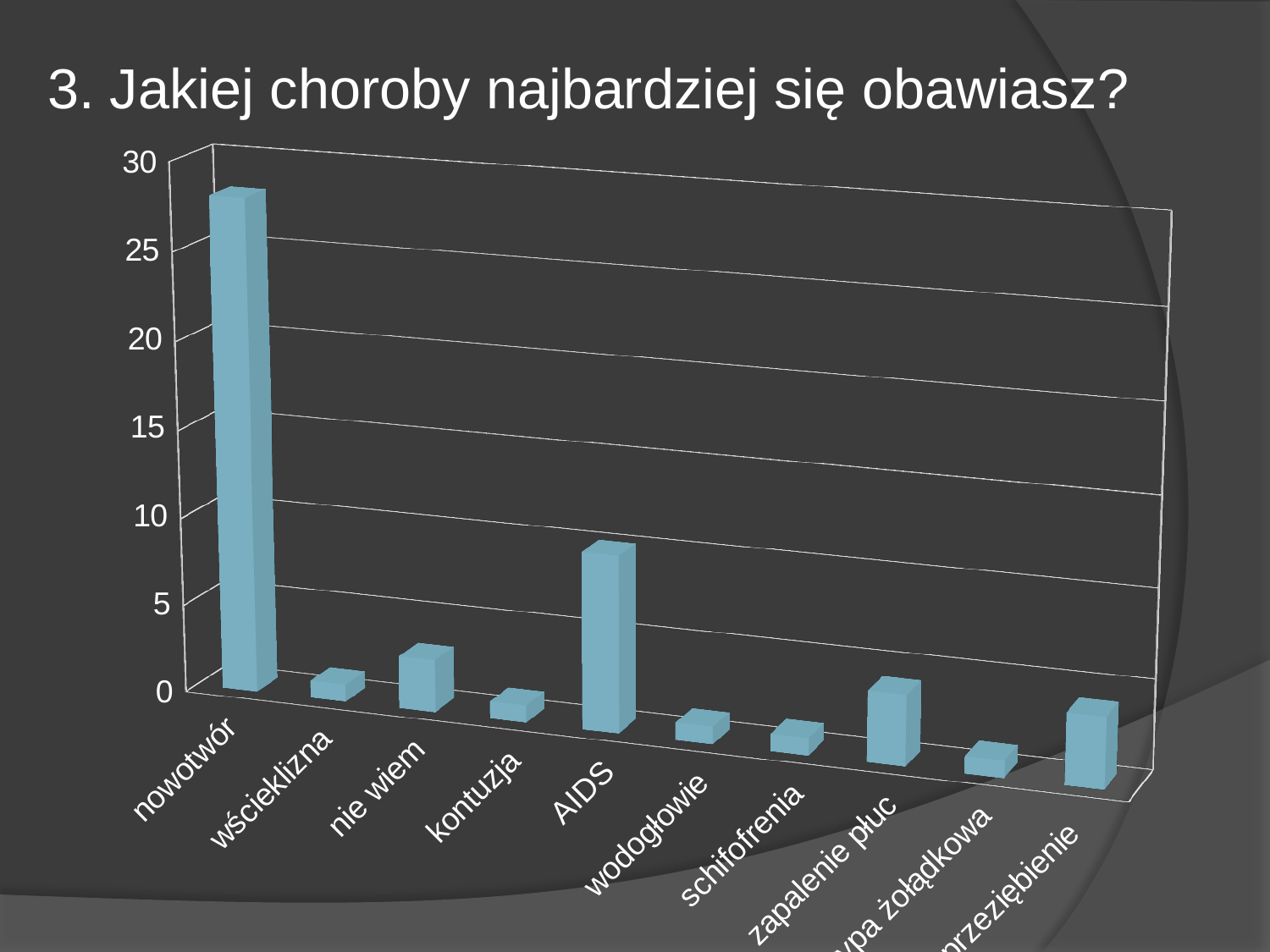
Which is larger, the value for AIDS or the value for nie wiem? AIDS Is the value for nie wiem greater or less than 5? less Which category has the highest value in the chart? nowotwór Which is larger, the value for nie wiem or the value for wścieklizna? nie wiem How many categories (bars) are plotted in the chart? 10 Which is larger, the value for zapalenie płuc or the value for schifofrenia? zapalenie płuc What is the title of the chart on the slide? 3. Jakiej choroby najbardziej się obawiasz? Is the value for nowotwór greater or less than 25? greater Is the value for AIDS greater or less than 5? greater What kind of chart is shown on the slide? bar chart